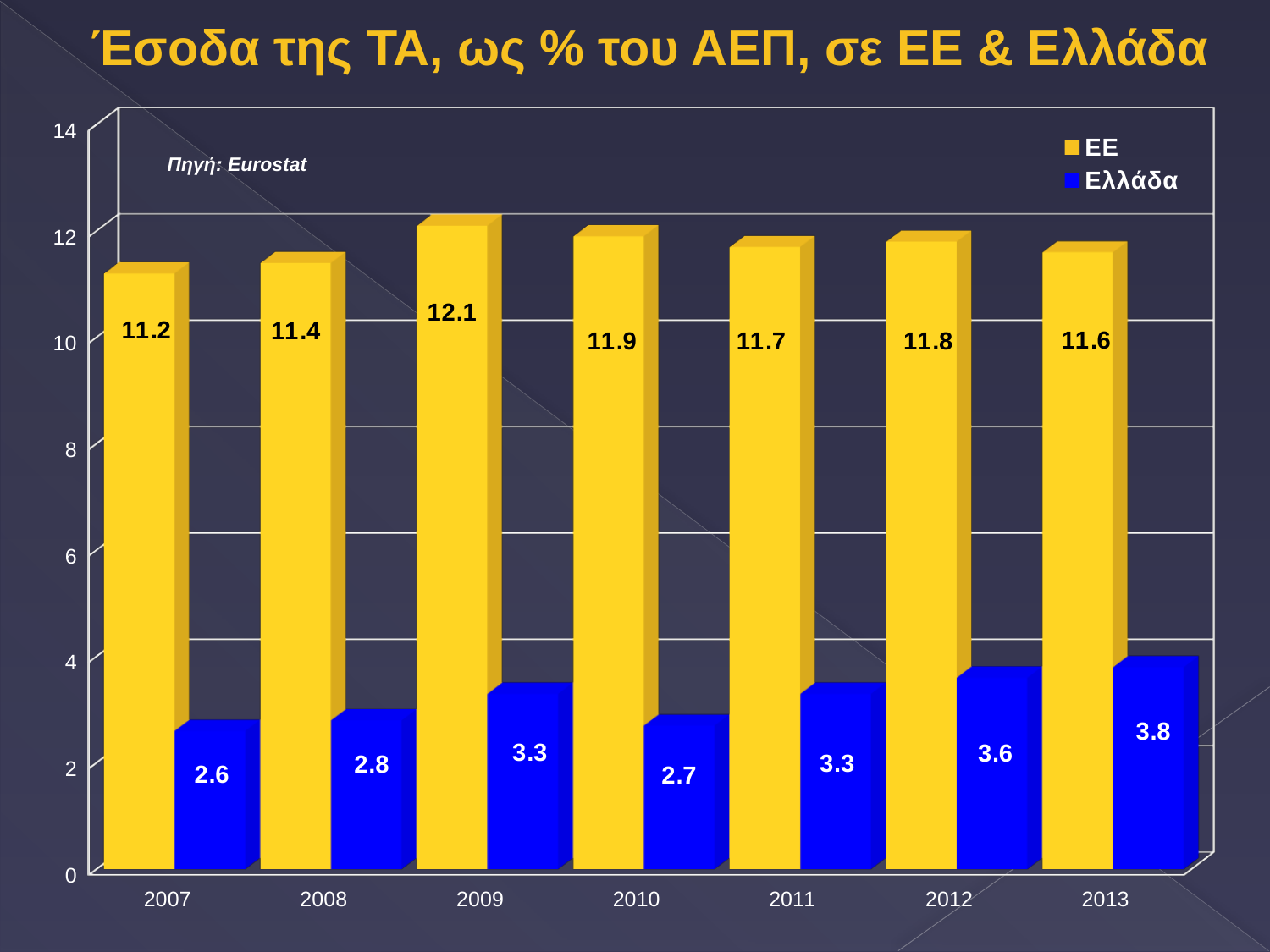
In which year is the ΕΕ value highest? 2009 In which year is the Ελλάδα value lowest? 2007 What is the difference between the ΕΕ and Ελλάδα values in 2007? 8.6 Which is larger, the Ελλάδα value in 2012 or in 2008? 2012 What is the value for Ελλάδα in 2013? 3.8 What kind of chart is shown on the slide? bar chart Does the Ελλάδα value rise or fall from 2010 to 2013? rise How many series does the legend list? 2 How many years are shown on the x axis? 7 What is the value for Ελλάδα in 2010? 2.7 What source is cited on the chart? Eurostat What is the value for ΕΕ in 2009? 12.1